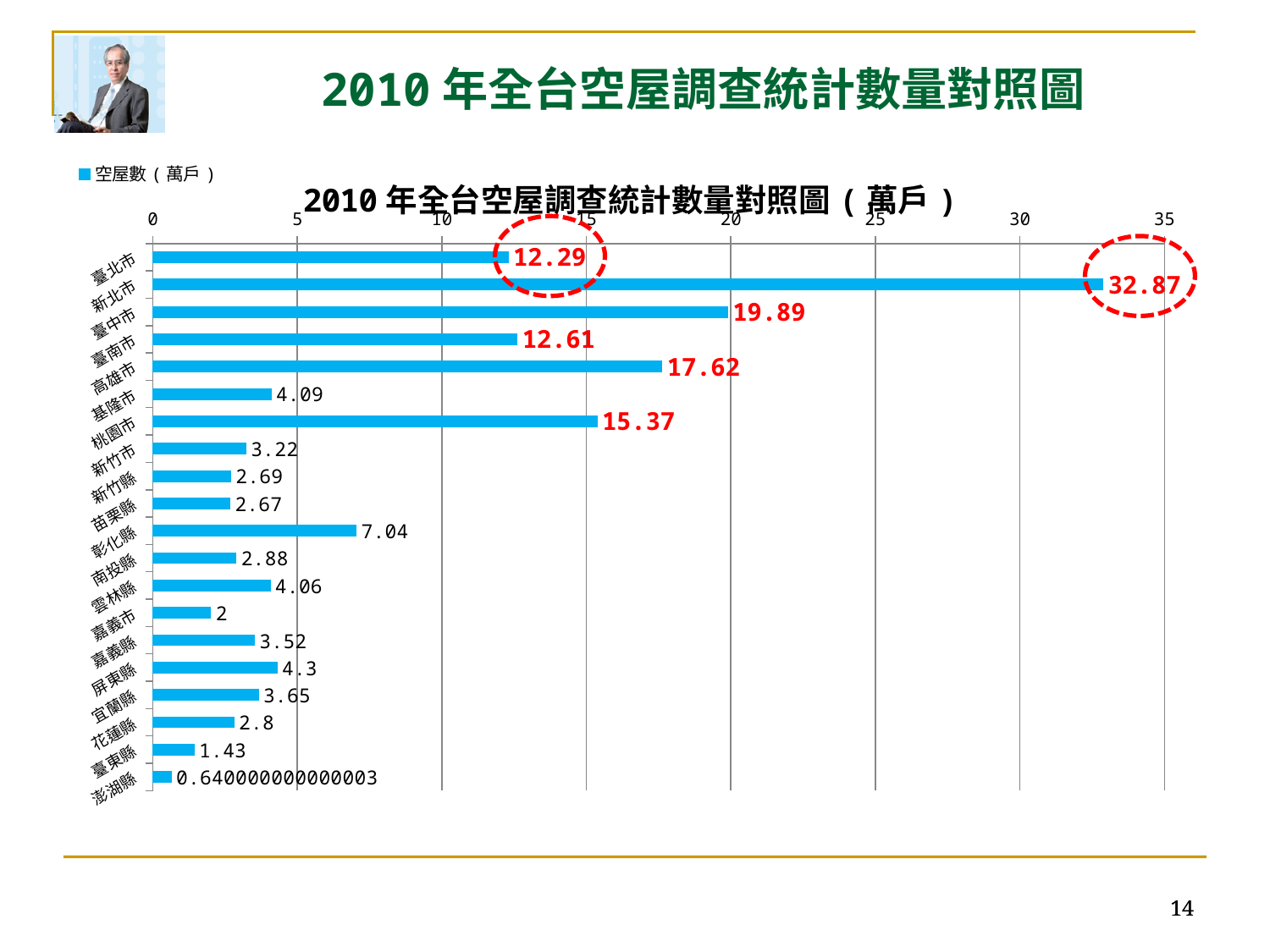
What is the legend entry for the series in the chart? 空屋數（萬戶） Which category has the lowest value? 澎湖縣 How many categories are shown in the chart? 20 What is the value for 新北市? 32.87 What is the value for 彰化縣? 7.04 Which is larger, the value for 臺南市 or the value for 臺北市? 臺南市 What is the difference between the values for 臺中市 and 高雄市? 2.27 What type of chart is shown on the slide? bar chart What is the value for 桃園市? 15.37 What is the value for 臺北市? 12.29 How many series does the legend list? 1 Which category has the highest value? 新北市